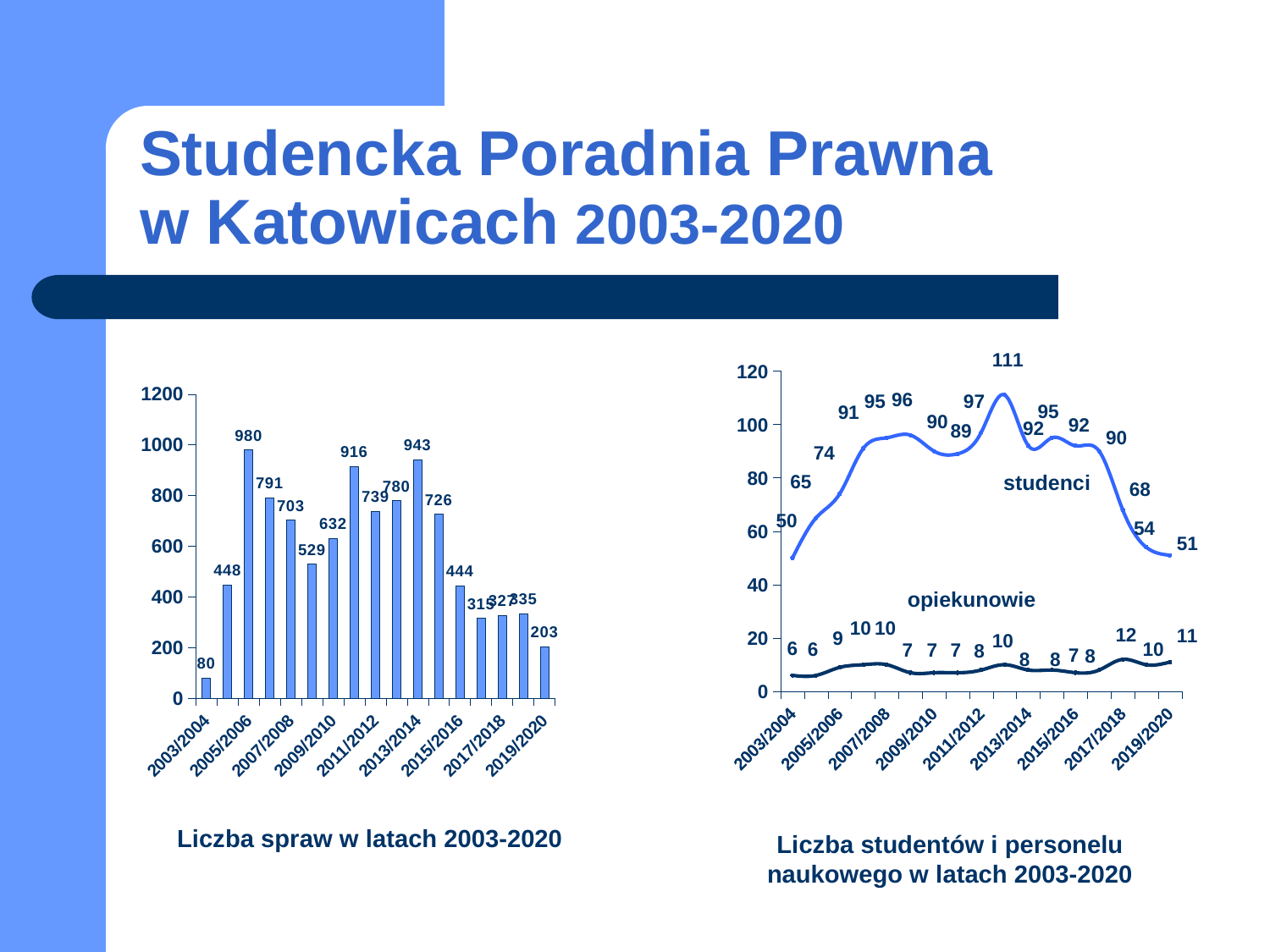
In the left chart 'Liczba spraw w latach 2003-2020', what is the value for 2005/2006? 980 In the right chart 'Liczba studentów i personelu naukowego w latach 2003-2020', what is the highest value of the 'studenci' series? 111 In the left chart 'Liczba spraw w latach 2003-2020', what is the value for 2003/2004? 80 In the right chart 'Liczba studentów i personelu naukowego w latach 2003-2020', what is the value of 'opiekunowie' for 2019/2020? 11 In the right chart 'Liczba studentów i personelu naukowego w latach 2003-2020', what is the value of 'studenci' for 2003/2004? 50 In the left chart 'Liczba spraw w latach 2003-2020', which year has the highest number of cases? 2005/2006 How many series does the right chart 'Liczba studentów i personelu naukowego w latach 2003-2020' show? 2 In the left chart 'Liczba spraw w latach 2003-2020', which year has the lowest number of cases? 2003/2004 In the left chart 'Liczba spraw w latach 2003-2020', what is the difference between the values for 2013/2014 and 2015/2016? 499 In the right chart 'Liczba studentów i personelu naukowego w latach 2003-2020', which series has higher values, 'studenci' or 'opiekunowie'? studenci In the left chart 'Liczba spraw w latach 2003-2020', is the value for 2019/2020 greater or less than 400? less What type of chart is the left chart, 'Liczba spraw w latach 2003-2020'? bar chart